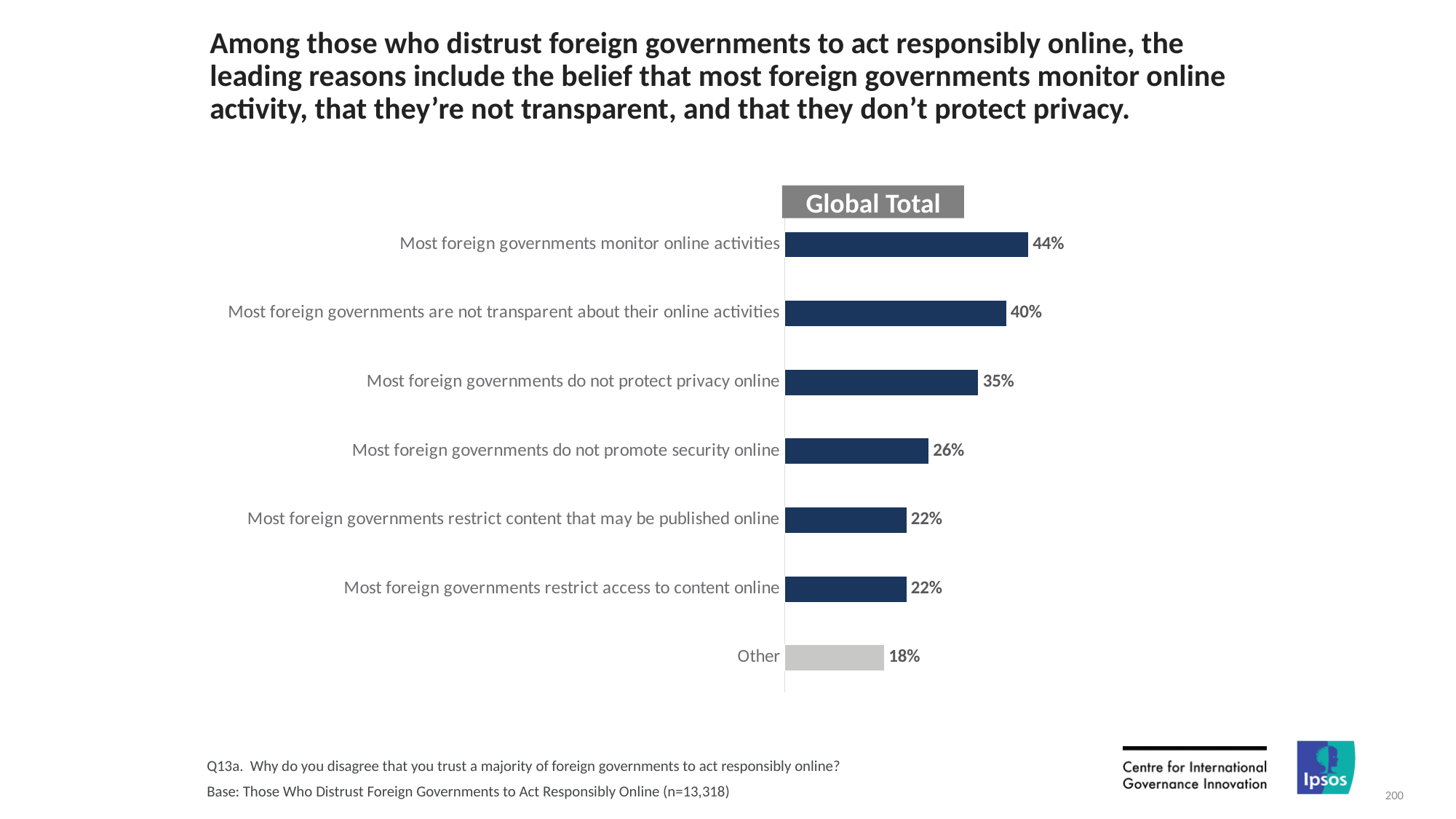
What is the difference between "Most foreign governments monitor online activities" and "Most foreign governments are not transparent about their online activities"? 4% What is the value for "Most foreign governments do not promote security online"? 26% What is the value for "Most foreign governments do not protect privacy online"? 35% How many categories are shown in the chart? 7 What kind of chart is shown on the slide? Bar chart Which is larger: "Most foreign governments do not promote security online" or "Most foreign governments restrict access to content online"? Most foreign governments do not promote security online What percentage is shown for "Other"? 18% Which reason has the highest percentage? Most foreign governments monitor online activities Which category has the lowest percentage? Other What is the difference between "Most foreign governments do not protect privacy online" and "Other"? 17% What percentage is shown for "Most foreign governments monitor online activities"? 44% What is the label shown in the grey box above the chart? Global Total